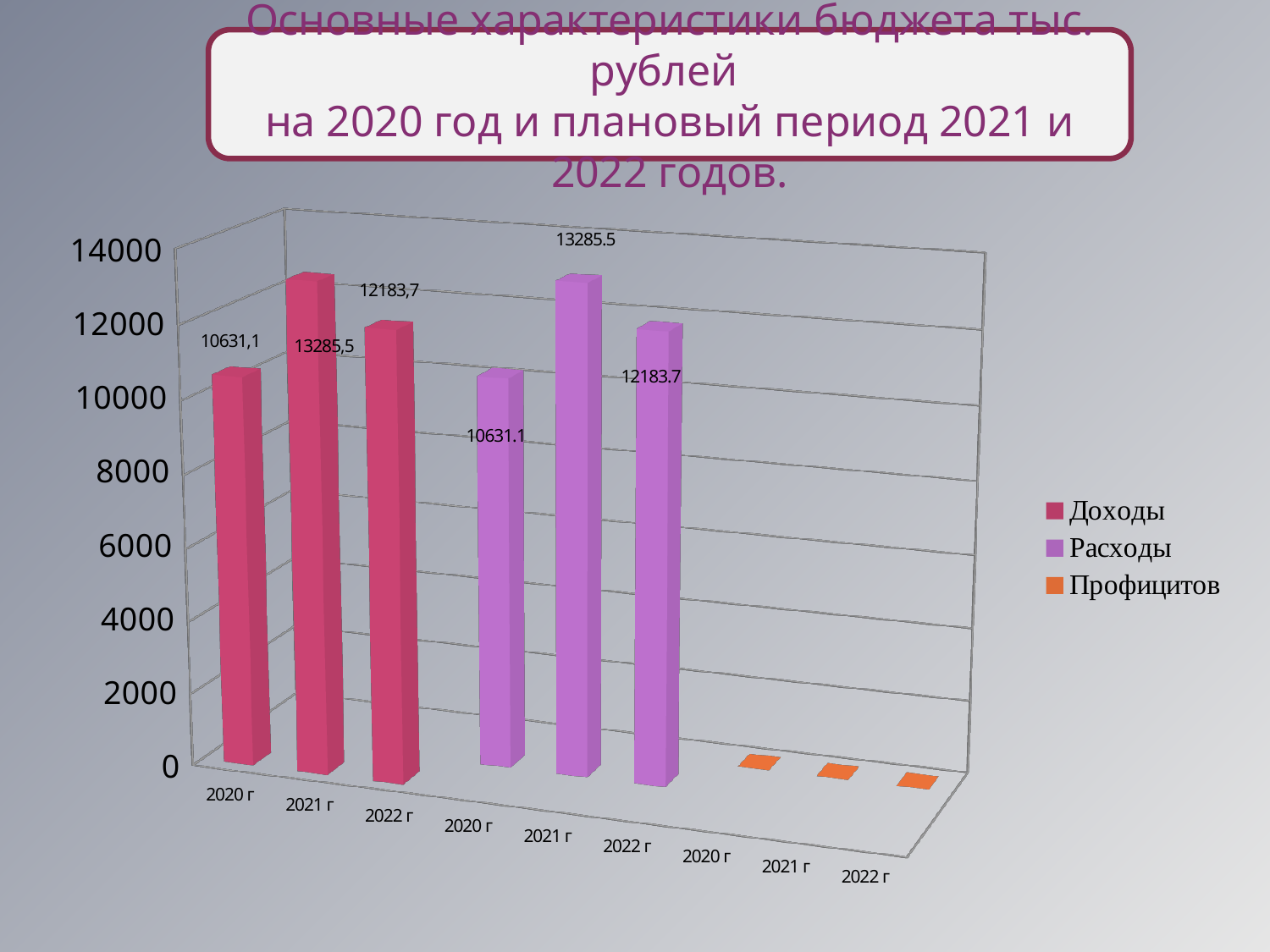
What is the value of Расходы for 2021 г? 13285.5 Which series is shown in orange in the legend? Профицитов Which year has the highest Доходы value? 2021 г What is the value of Доходы for 2021 г? 13285,5 What is the value of Доходы for 2020 г? 10631,1 What type of chart is shown on the slide? bar chart Is the value of Доходы for 2020 г greater or less than 12000? less Which year has the lowest Расходы value? 2020 г How many series does the legend list? 3 What is the value of Расходы for 2022 г? 12183.7 Is the value of Расходы for 2021 г greater or less than 12000? greater Which is larger, Доходы for 2021 г or Доходы for 2022 г? Доходы for 2021 г